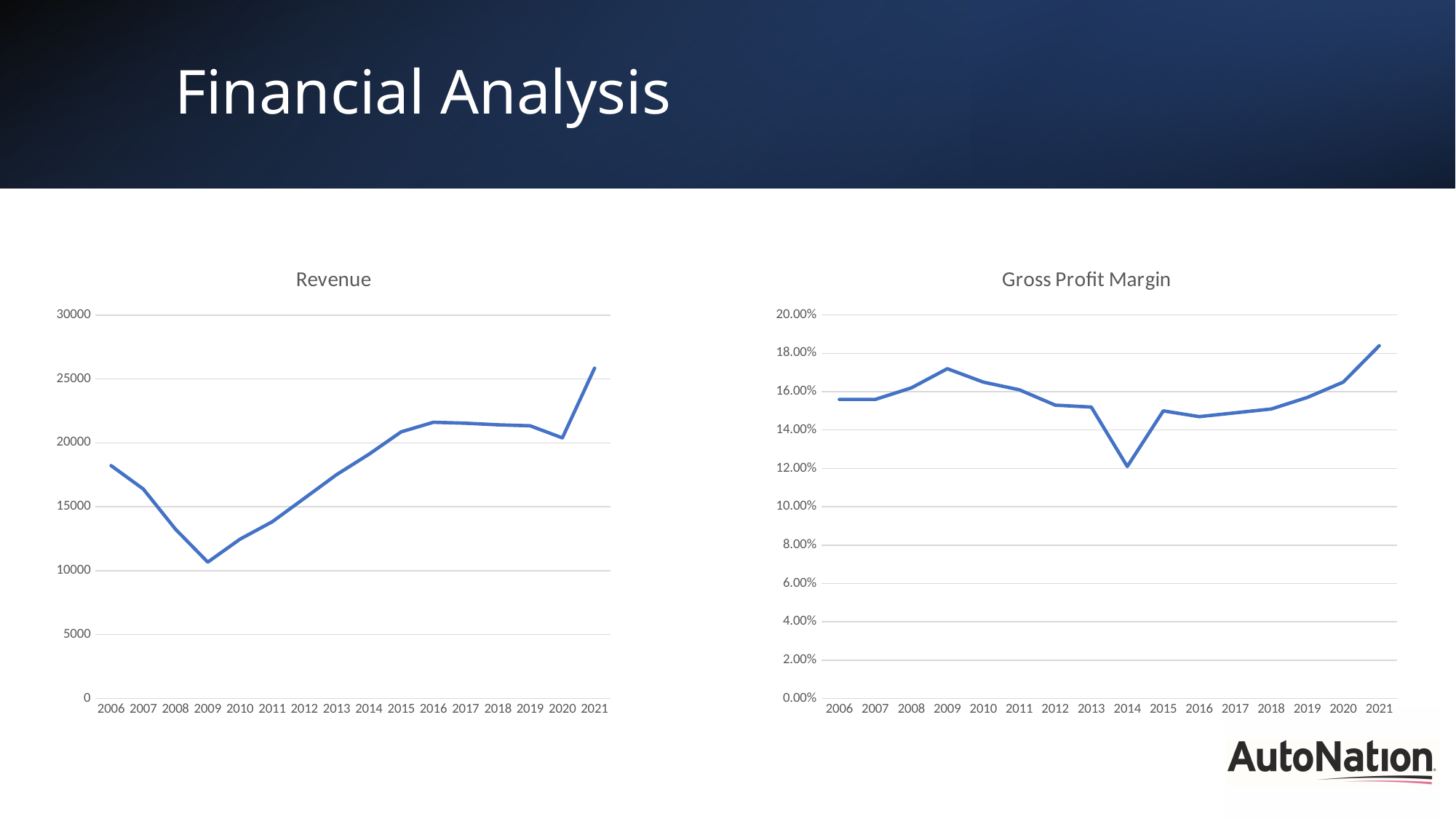
How many years are plotted on the Gross Profit Margin chart? 16 In the Revenue chart, is the value for 2009 greater or less than 15000? less What is the title of the chart on the right side of the slide? Gross Profit Margin In the Gross Profit Margin chart, which year has the highest gross profit margin? 2021 What kind of chart is the Revenue chart? line chart In the Revenue chart, which year has the highest revenue? 2021 In the Revenue chart, which year has the lowest revenue? 2009 In the Revenue chart, which year has the larger revenue, 2006 or 2009? 2006 In the Gross Profit Margin chart, which year has the lowest gross profit margin? 2014 In the Gross Profit Margin chart, is the value for 2014 greater or less than 14.00%? less In the Revenue chart, is the value for 2021 greater or less than 25000? greater In the Gross Profit Margin chart, does the value rise or fall from 2014 to 2021? rise